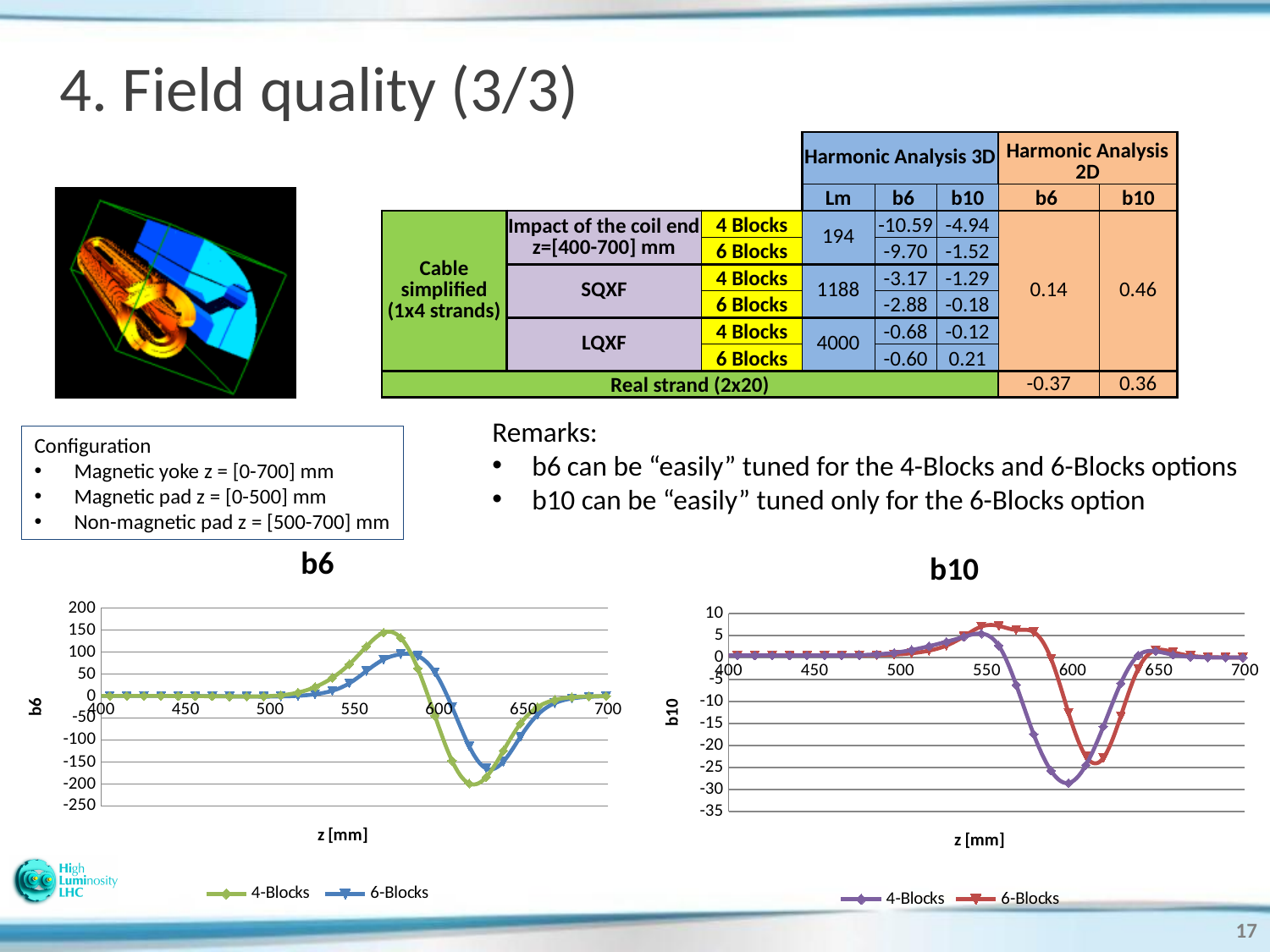
What are the two series named in the legend of the b6 chart? 4-Blocks and 6-Blocks In the b6 chart, is the peak value of the 4-Blocks series greater or less than 100? greater In the b10 chart, which series reaches the higher peak value, 4-Blocks or 6-Blocks? 6-Blocks In the b6 chart, which series reaches the higher peak value, 4-Blocks or 6-Blocks? 4-Blocks How many series does the legend of the b10 chart list? 2 What is the x-axis label of the b10 chart? z [mm] In the b6 chart, is the minimum value of the 4-Blocks series greater or less than -150? less In the b6 chart, which series reaches the lowest value? 4-Blocks In the b6 chart, does the 4-Blocks series rise or fall between z = 575 and z = 600? fall In the b10 chart, is the minimum value of the 4-Blocks series greater or less than -25? less In the b10 chart, which series reaches the lowest value? 4-Blocks What kind of chart is the b6 chart? line chart